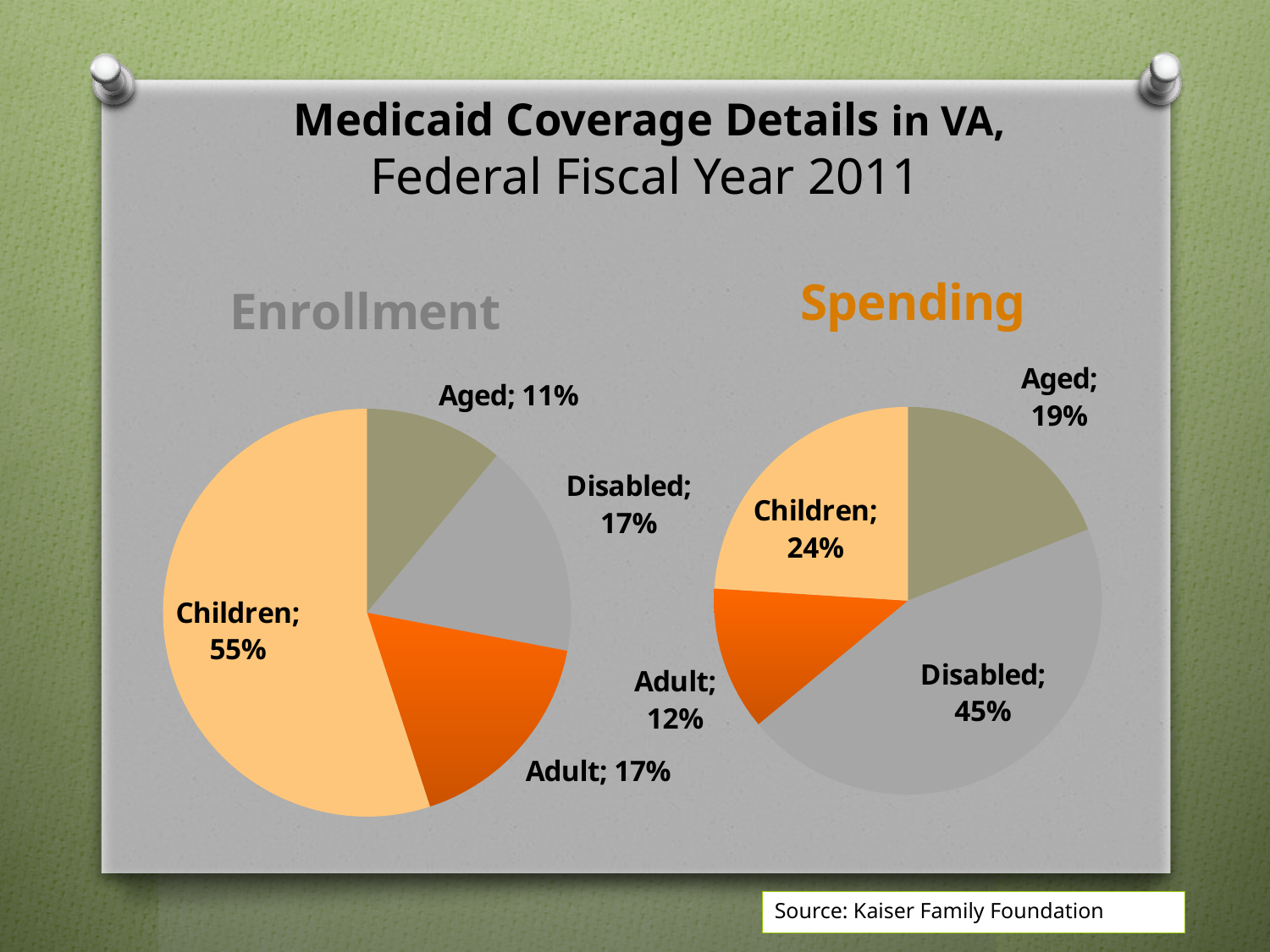
What is the difference between the Disabled share in the Spending chart and the Disabled share in the Enrollment chart? 28% In the Enrollment pie chart, which category has the largest slice? Children How many categories does the Enrollment pie chart show? 4 In the Enrollment pie chart, which category has the smallest slice? Aged What type of chart is used for Spending? Pie chart In the Enrollment pie chart, what is the value for Aged? 11% What is the title of the slide containing the two charts? Medicaid Coverage Details in VA, Federal Fiscal Year 2011 In the Spending pie chart, what is the value for Adult? 12% In the Enrollment pie chart, what share of enrollment is Children? 55% In the Spending pie chart, what share of spending is Disabled? 45% In the Spending pie chart, which is larger: Children or Aged? Children In the Spending pie chart, which category has the smallest slice? Adult